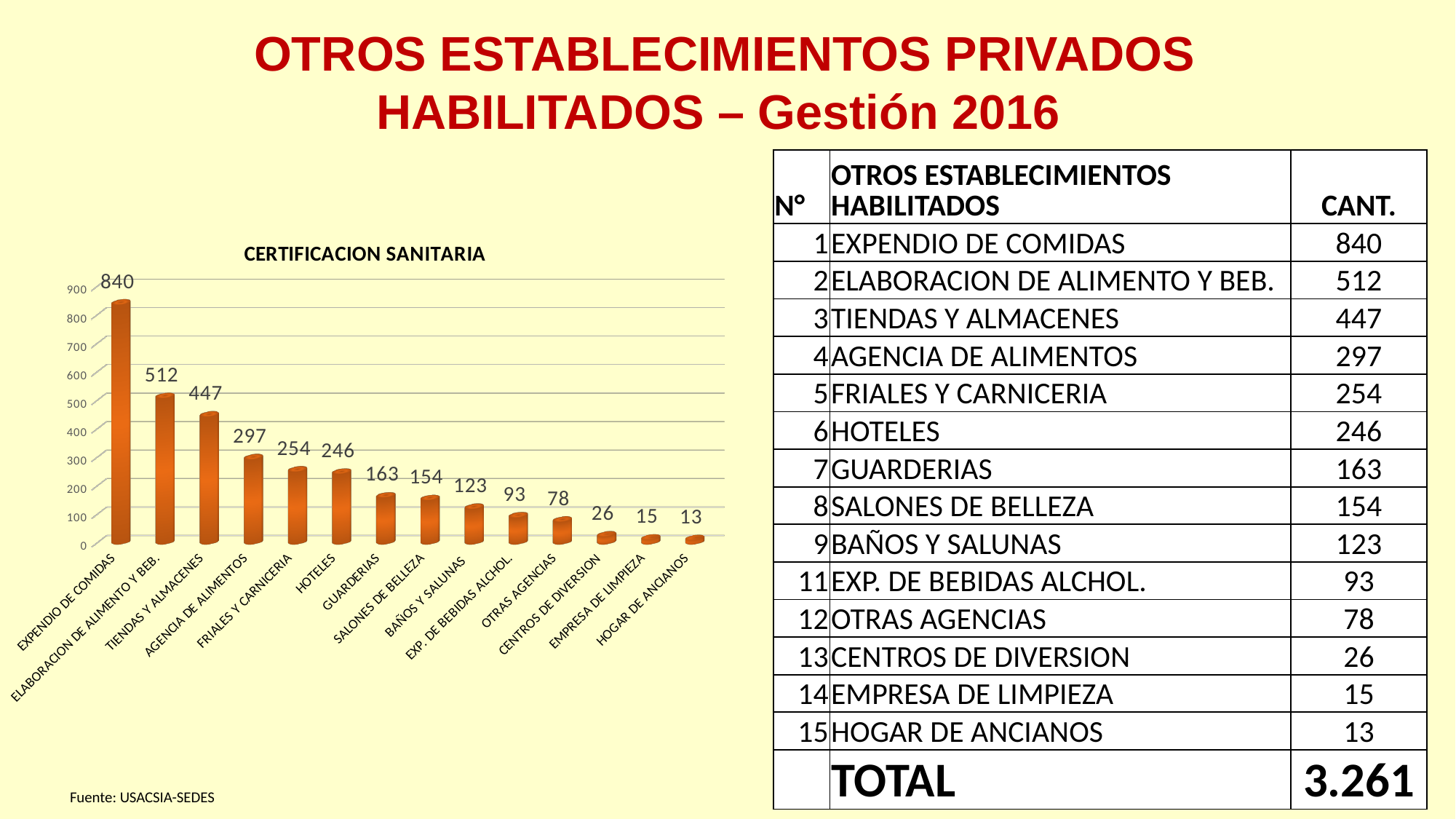
How many categories are shown in the CERTIFICACION SANITARIA chart? 14 What is the value for HOTELES in the CERTIFICACION SANITARIA chart? 246 What kind of chart is the CERTIFICACION SANITARIA chart? bar chart Which category has the highest value in the CERTIFICACION SANITARIA chart? EXPENDIO DE COMIDAS Which category has the lowest value in the CERTIFICACION SANITARIA chart? HOGAR DE ANCIANOS Do the values in the CERTIFICACION SANITARIA chart rise or fall from left to right along the x axis? fall What is the difference between the values for EXPENDIO DE COMIDAS and ELABORACION DE ALIMENTO Y BEB.? 328 What is the difference between the values for GUARDERIAS and SALONES DE BELLEZA? 9 What is the value for EXPENDIO DE COMIDAS in the CERTIFICACION SANITARIA chart? 840 Is the value for OTRAS AGENCIAS greater or less than 100? less What is the value for BAÑOS Y SALUNAS in the chart? 123 Which is larger in the chart, the value for AGENCIA DE ALIMENTOS or the value for TIENDAS Y ALMACENES? TIENDAS Y ALMACENES